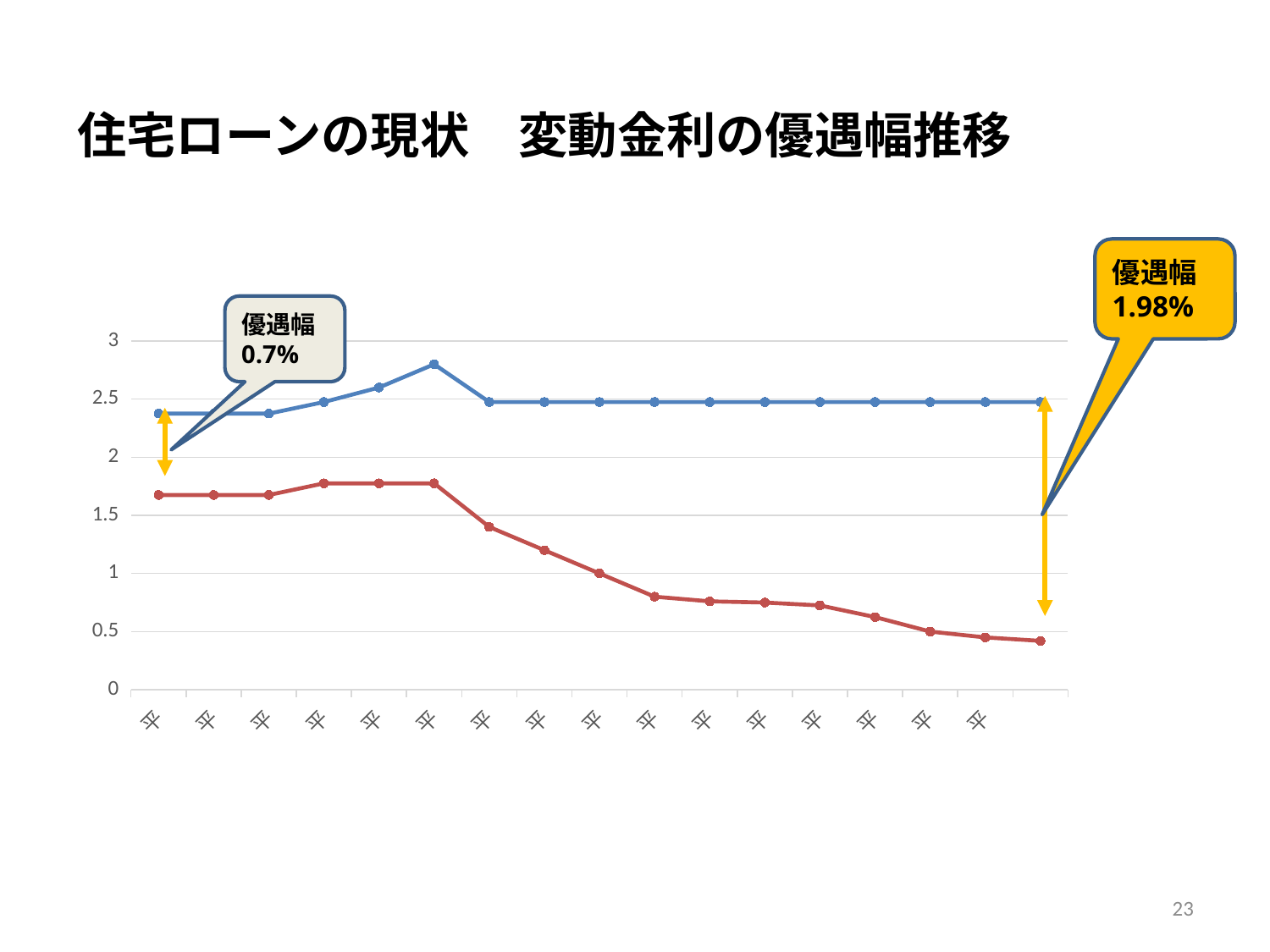
At the right end of the chart, which line has the higher value, the blue line or the red line? blue line Is the last point of the blue line greater or less than 2? greater What 優遇幅 value does the callout at the right (end) of the chart show? 1.98% What kind of chart is shown on the slide? line chart How many lines are plotted on the chart? 2 What 優遇幅 value does the callout at the left (start) of the chart show? 0.7% Is the last point of the red line greater or less than 0.5? less What is the highest value shown on the y axis? 3 Is the first point of the red line greater or less than 1.5? greater What is the title of the slide above the chart? 住宅ローンの現状 変動金利の優遇幅推移 Does the red line rise or fall overall from left to right along the x axis? fall